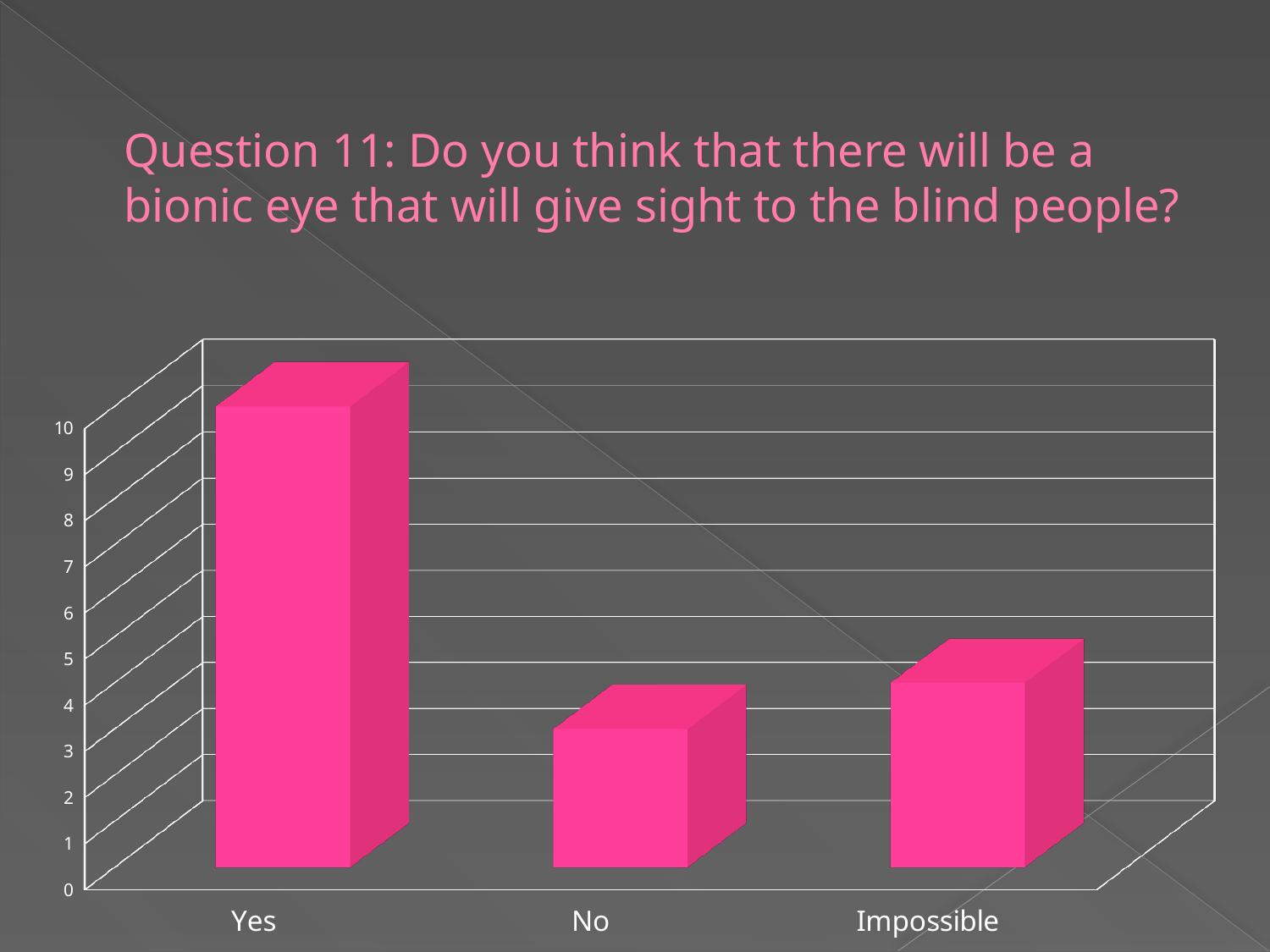
What kind of chart is shown on the slide? bar chart Which category has the highest bar in the chart? Yes What colour are the bars in the chart? pink Is the value for No greater or less than 5? less How many categories are shown on the x axis of the chart? 3 Is the value for Yes greater or less than 5? greater Which is larger, the value for Yes or the value for No? Yes Is the value for Impossible greater or less than 8? less Which category has the lowest bar in the chart? No What is the title of the chart on the slide? Question 11: Do you think that there will be a bionic eye that will give sight to the blind people? Which is larger, the value for Impossible or the value for No? Impossible